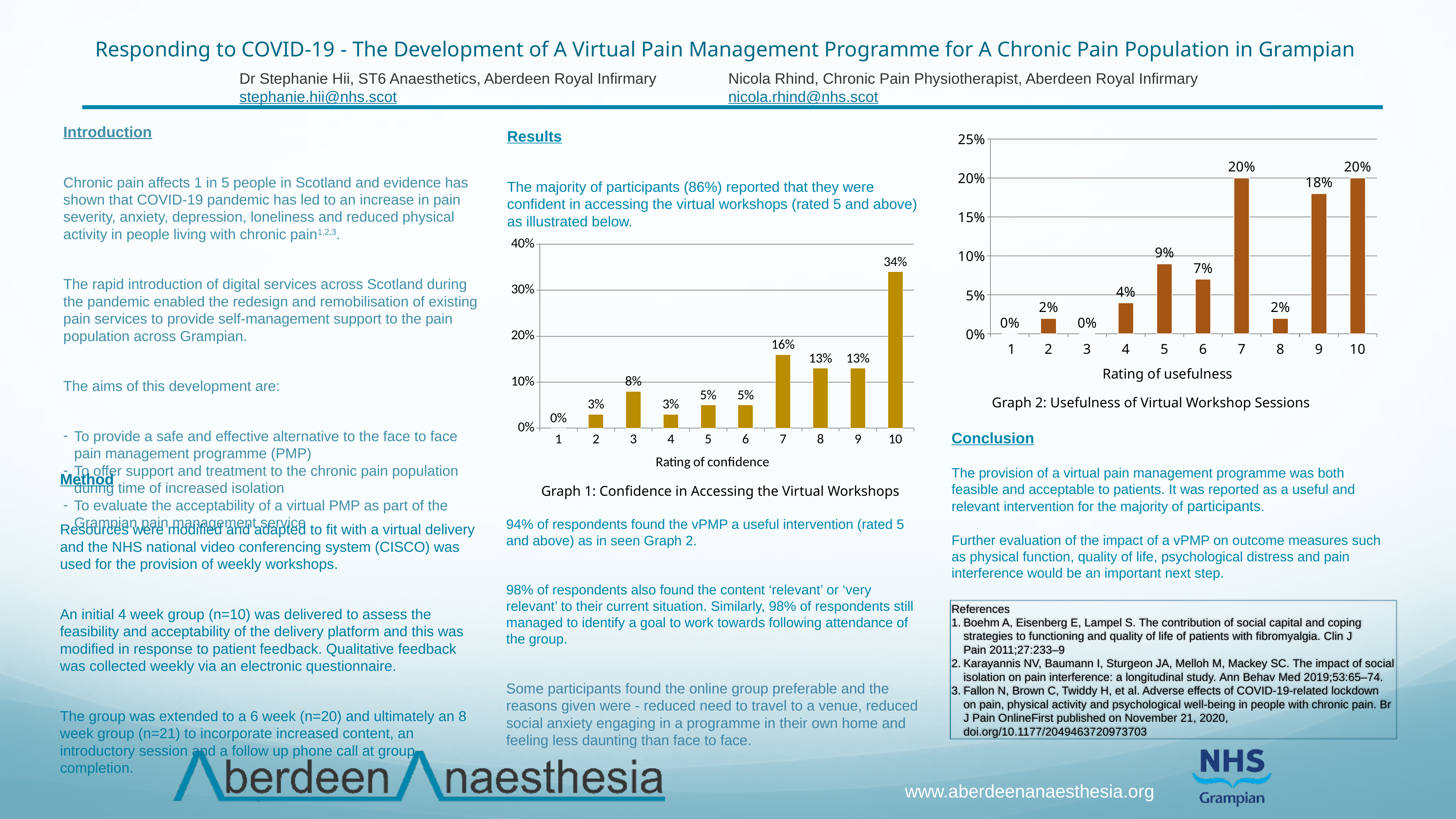
In Graph 1: Confidence in Accessing the Virtual Workshops, which rating of confidence has the lowest value? 1 In Graph 1: Confidence in Accessing the Virtual Workshops, which rating of confidence has the highest value? 10 In Graph 1: Confidence in Accessing the Virtual Workshops, what is the value for a rating of confidence of 10? 34% In Graph 2: Usefulness of Virtual Workshop Sessions, which is larger, the value for rating 5 or the value for rating 6? Rating 5 In Graph 2: Usefulness of Virtual Workshop Sessions, what is the difference between the values for ratings 7 and 9? 2% In Graph 1: Confidence in Accessing the Virtual Workshops, how many rating categories are shown on the x axis? 10 What type of chart is Graph 1: Confidence in Accessing the Virtual Workshops? Bar chart In Graph 1: Confidence in Accessing the Virtual Workshops, what is the difference between the values for ratings 10 and 7? 18% In Graph 2: Usefulness of Virtual Workshop Sessions, what is the value for a rating of usefulness of 9? 18% What is the x-axis label of Graph 2: Usefulness of Virtual Workshop Sessions? Rating of usefulness In Graph 1: Confidence in Accessing the Virtual Workshops, what is the value for a rating of confidence of 7? 16% In Graph 2: Usefulness of Virtual Workshop Sessions, what is the value for a rating of usefulness of 5? 9%